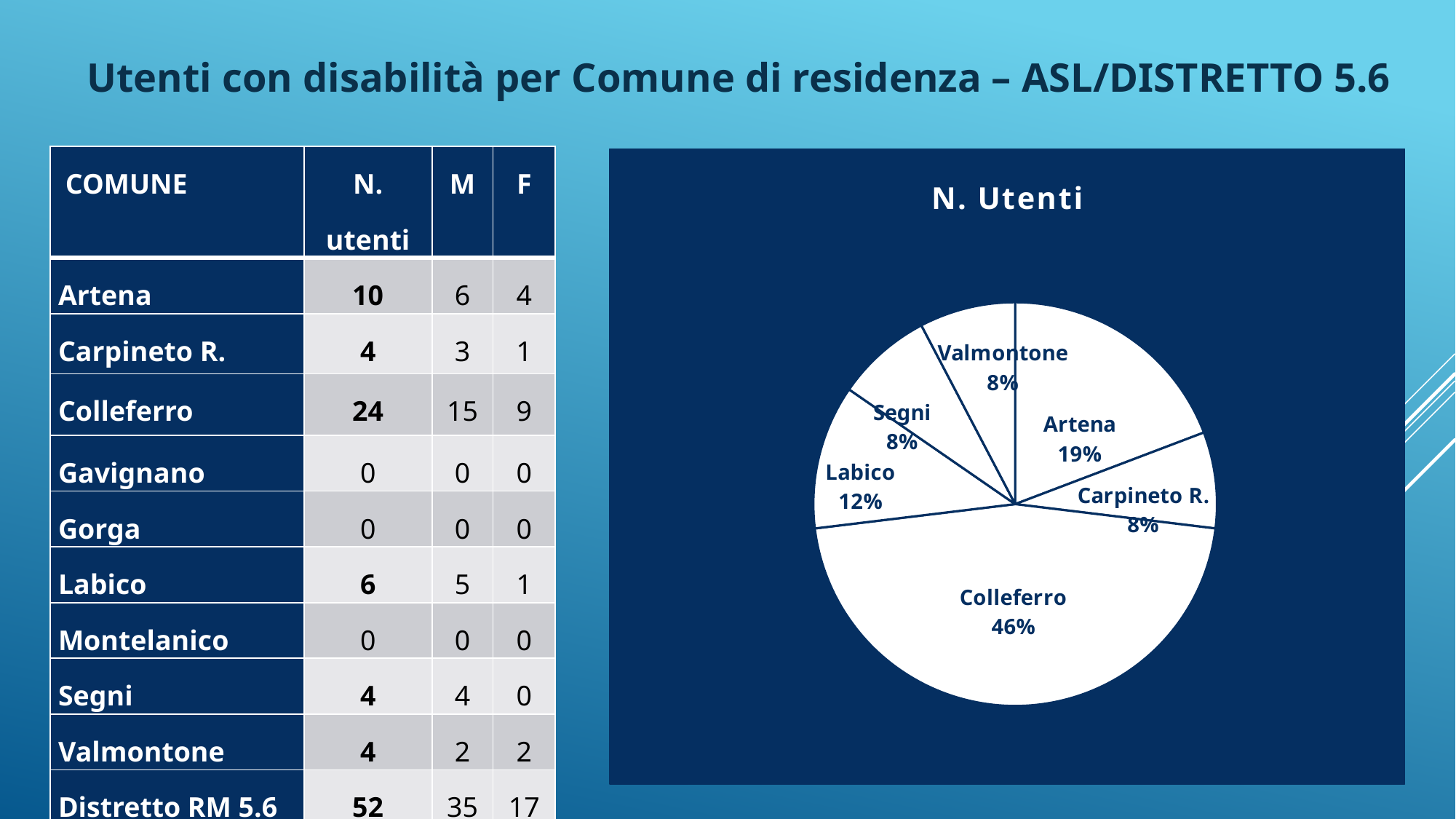
What share of the pie does Colleferro have? 46% What type of chart is shown on the slide? pie chart What share of the pie does Valmontone have? 8% What share of the pie does Labico have? 12% Which slice is larger, Artena or Labico? Artena Which slice is larger, Labico or Carpineto R.? Labico Which comune has the largest slice of the pie? Colleferro What is the title of the chart? N. Utenti How many slices does the pie chart have? 6 What is the difference in percentage points between the Colleferro slice and the Artena slice? 27